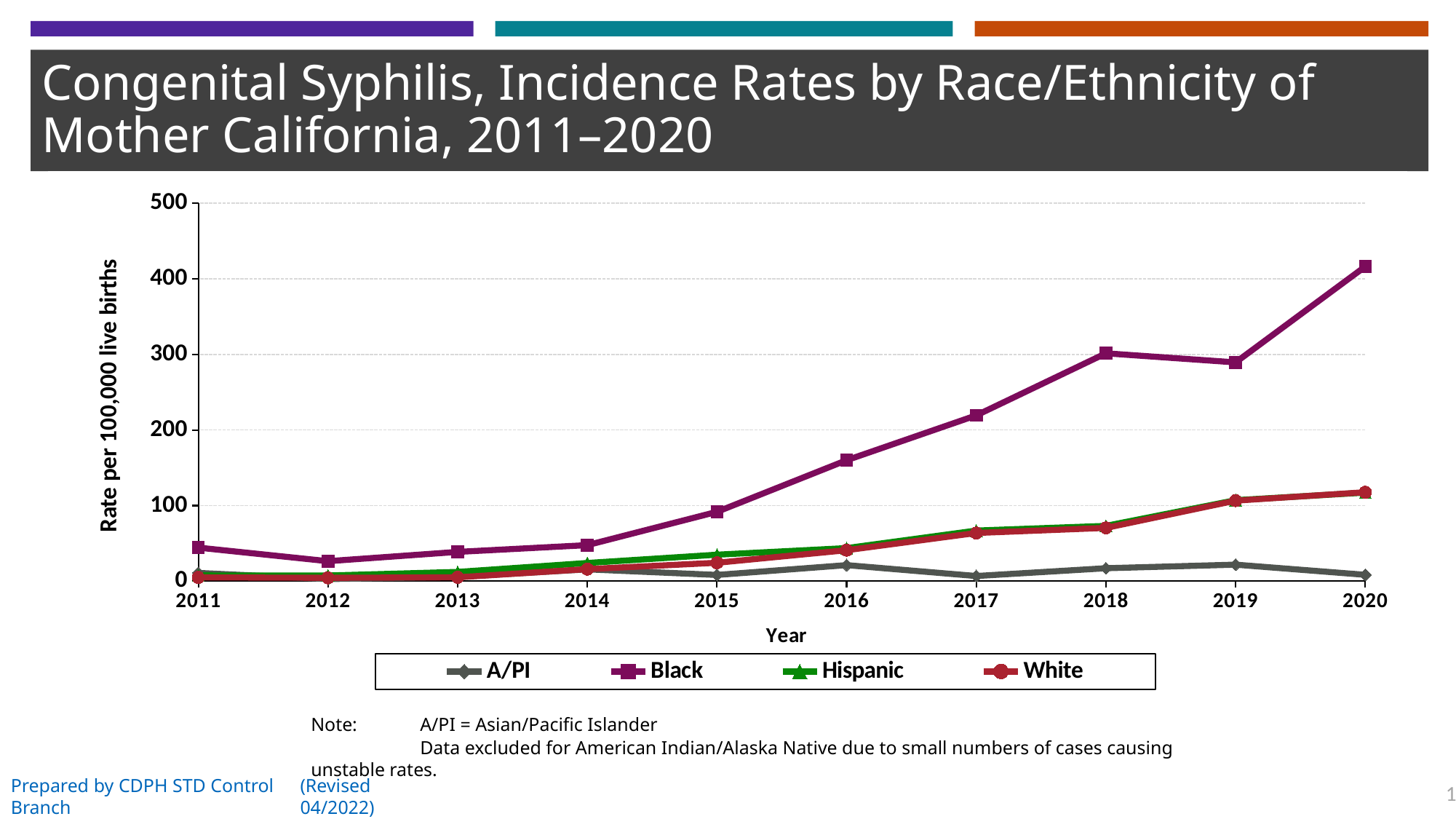
Is the value for Black in 2017 greater or less than 200? greater How many series does the legend list? 4 How many years are plotted along the x axis? 10 Does the rate for Black generally rise or fall from 2012 to 2020? rise Is the value for Black in 2015 greater or less than 100? less Is the value for A/PI in 2019 greater or less than 100? less Which race/ethnicity has the lowest rate in 2020? A/PI Which race/ethnicity has the highest rate in 2020? Black What is the label of the y axis? Rate per 100,000 live births Which is larger in 2017, the rate for Black or the rate for White? Black What kind of chart is shown on the slide? line chart